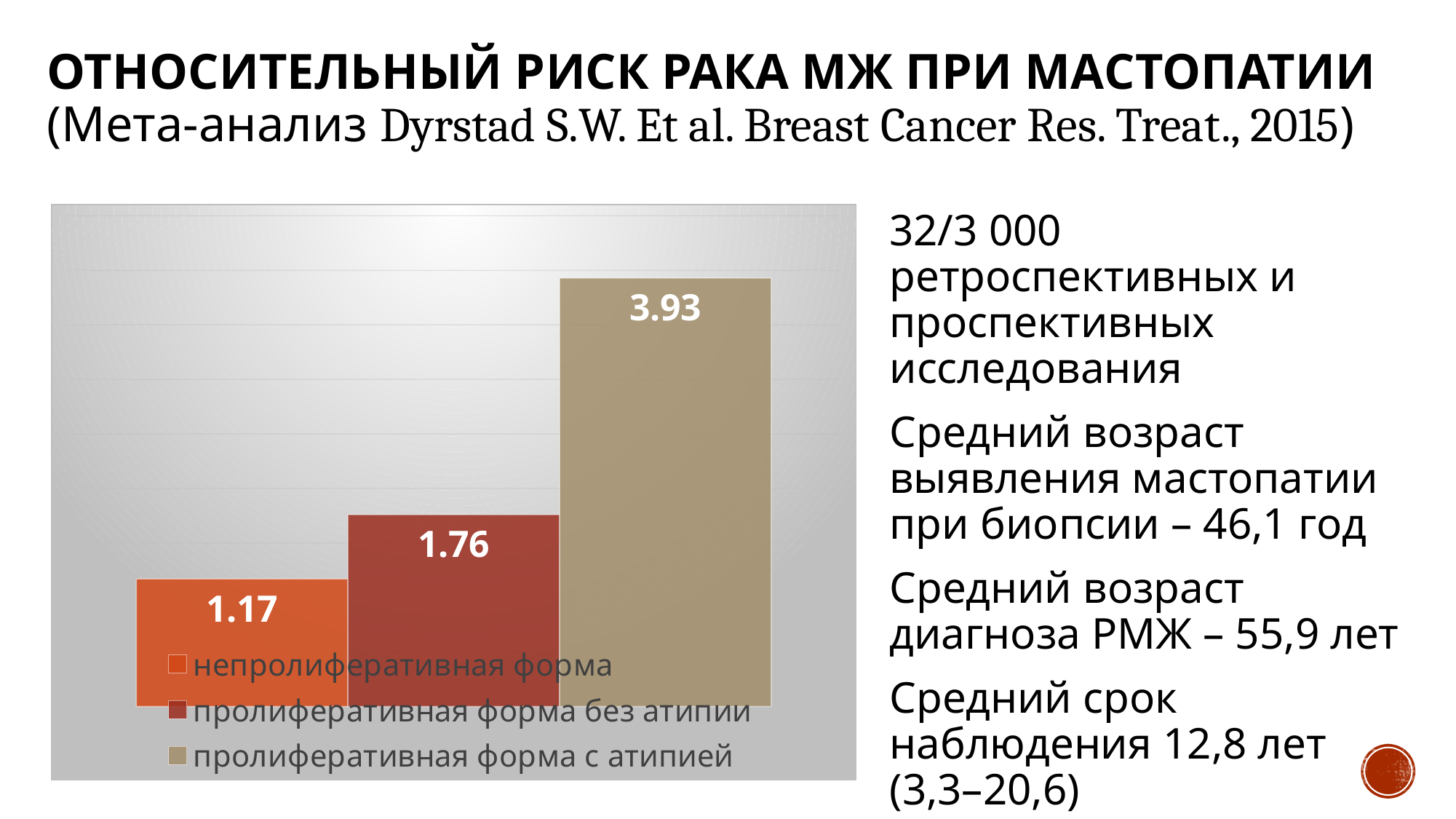
What type of chart is shown on the slide? bar chart What colour is the bar for пролиферативная форма с атипией? tan (beige-brown) What is the relative risk value shown for пролиферативная форма с атипией? 3.93 Which form has the lowest relative risk in the chart? непролиферативная форма Which is larger: the relative risk for пролиферативная форма без атипии or for непролиферативная форма? пролиферативная форма без атипии What is the difference between the relative risk for пролиферативная форма без атипии and непролиферативная форма? 0.59 How many entries does the chart legend list? 3 What is the relative risk value shown for пролиферативная форма без атипии? 1.76 What is the relative risk value shown for непролиферативная форма? 1.17 Which form has the highest relative risk in the chart? пролиферативная форма с атипией What is the difference between the relative risk for пролиферативная форма с атипией and непролиферативная форма? 2.76 How many bars are plotted in the chart? 3